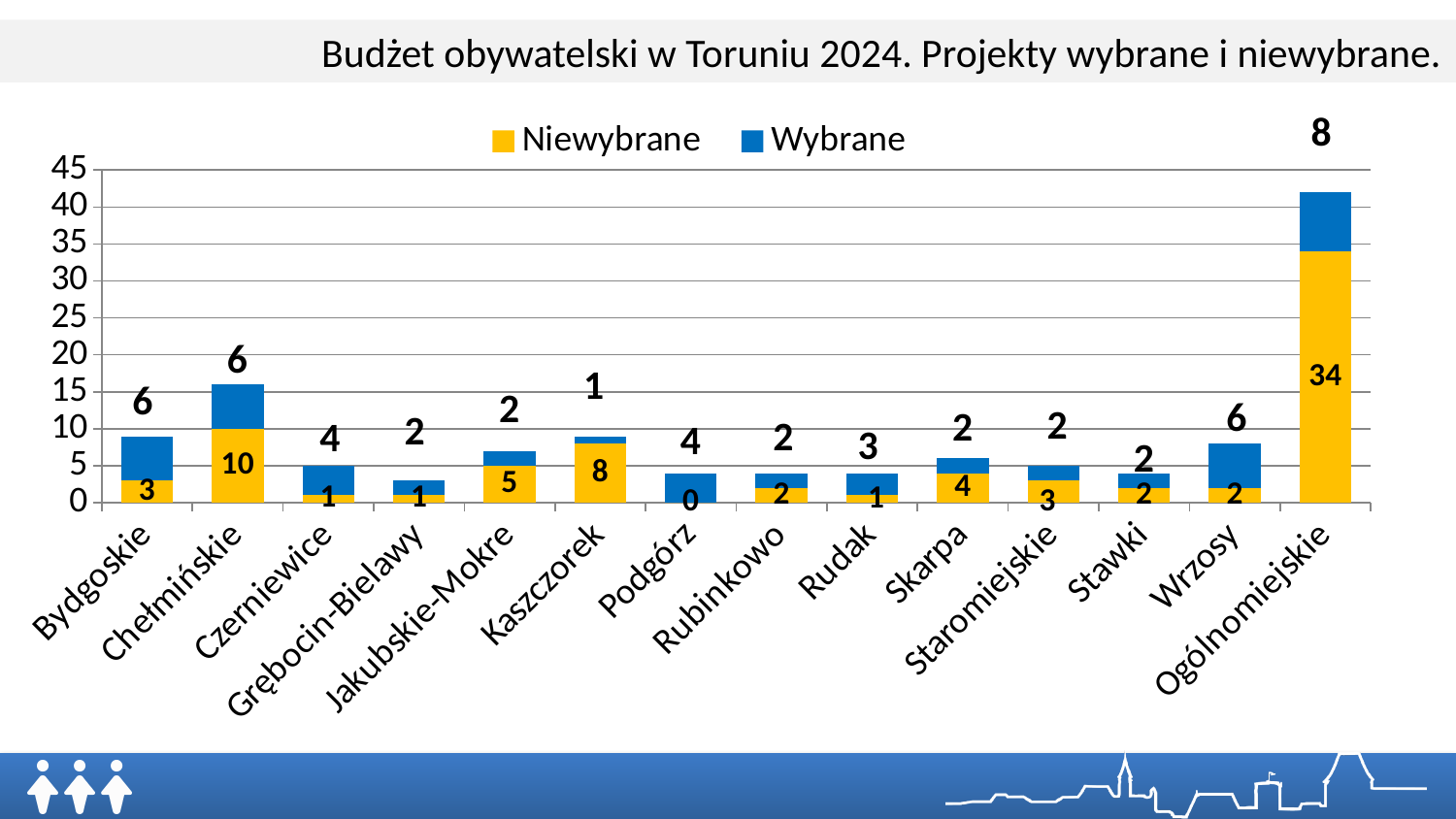
What is the Wybrane value for Chełmińskie? 6 Which category has the lowest Wybrane value? Kaszczorek What is the difference between the Niewybrane values for Kaszczorek and Jakubskie-Mokre? 3 What is the Niewybrane value for Podgórz? 0 Is the total stacked value for Ogólnomiejskie greater or less than 40? greater How many series does the legend list? 2 Which category has the highest Niewybrane value? Ogólnomiejskie What kind of chart is shown on the slide? stacked bar chart How many categories are shown on the x axis? 14 Which is larger, the Wybrane value for Wrzosy or the Wybrane value for Skarpa? Wrzosy What is the Niewybrane value for Ogólnomiejskie? 34 What is the total of the stacked bar for Chełmińskie? 16